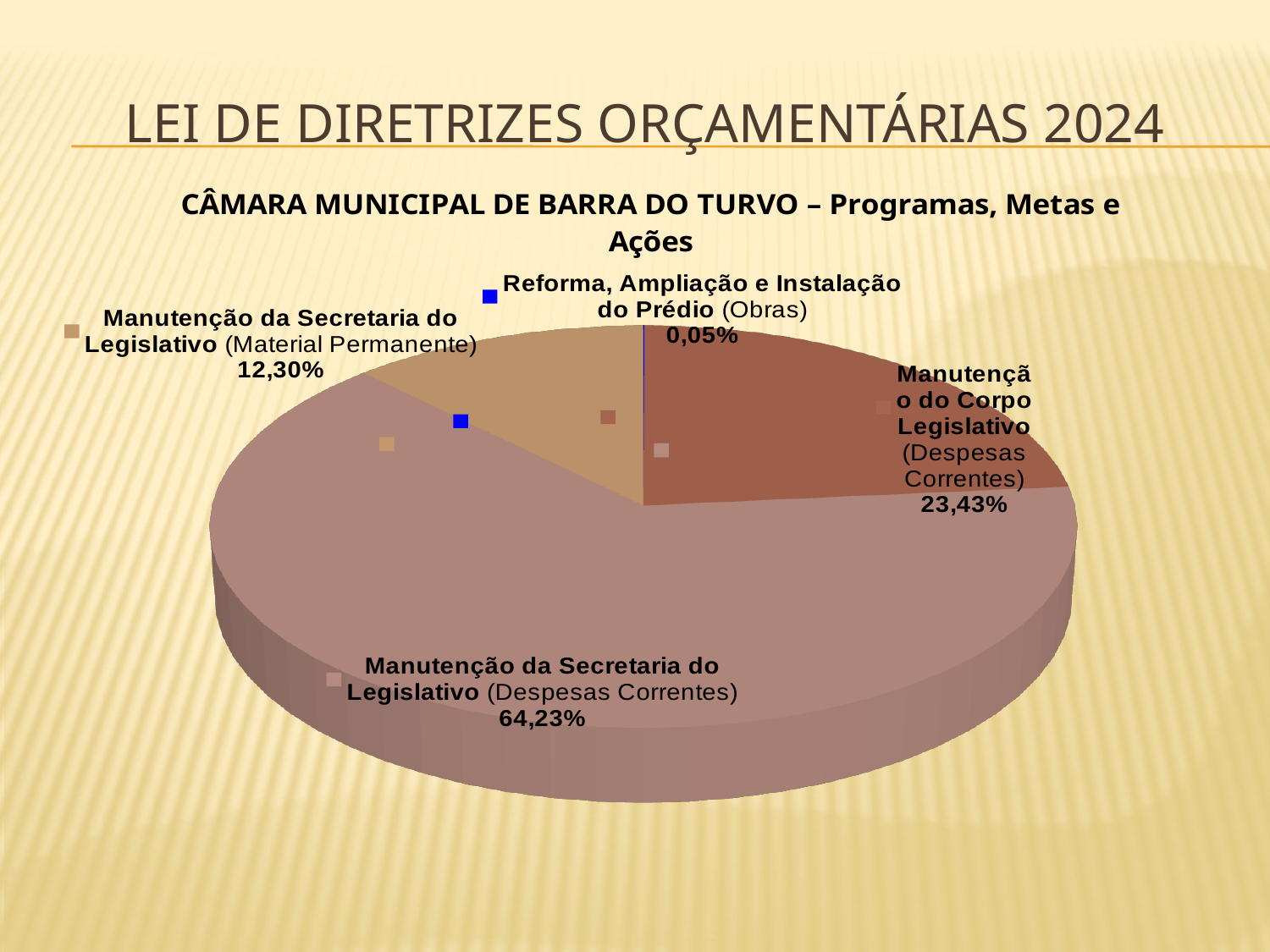
Which is larger: Manutenção do Corpo Legislativo (Despesas Correntes) or Manutenção da Secretaria do Legislativo (Material Permanente)? Manutenção do Corpo Legislativo (Despesas Correntes) Which slice of the pie is the smallest? Reforma, Ampliação e Instalação do Prédio (Obras) What share of the pie is Manutenção da Secretaria do Legislativo (Despesas Correntes)? 64,23% What is the difference in percentage points between Manutenção da Secretaria do Legislativo (Material Permanente) and Reforma, Ampliação e Instalação do Prédio (Obras)? 12,25 How many slices does the pie chart have? 4 What is the title of the chart? CÂMARA MUNICIPAL DE BARRA DO TURVO – Programas, Metas e Ações What kind of chart is shown on the slide? Pie chart What share of the pie is Manutenção do Corpo Legislativo (Despesas Correntes)? 23,43% What share of the pie is Reforma, Ampliação e Instalação do Prédio (Obras)? 0,05% What share of the pie is Manutenção da Secretaria do Legislativo (Material Permanente)? 12,30% Which slice of the pie is the largest? Manutenção da Secretaria do Legislativo (Despesas Correntes) What is the difference in percentage points between Manutenção da Secretaria do Legislativo (Despesas Correntes) and Manutenção do Corpo Legislativo (Despesas Correntes)? 40,80